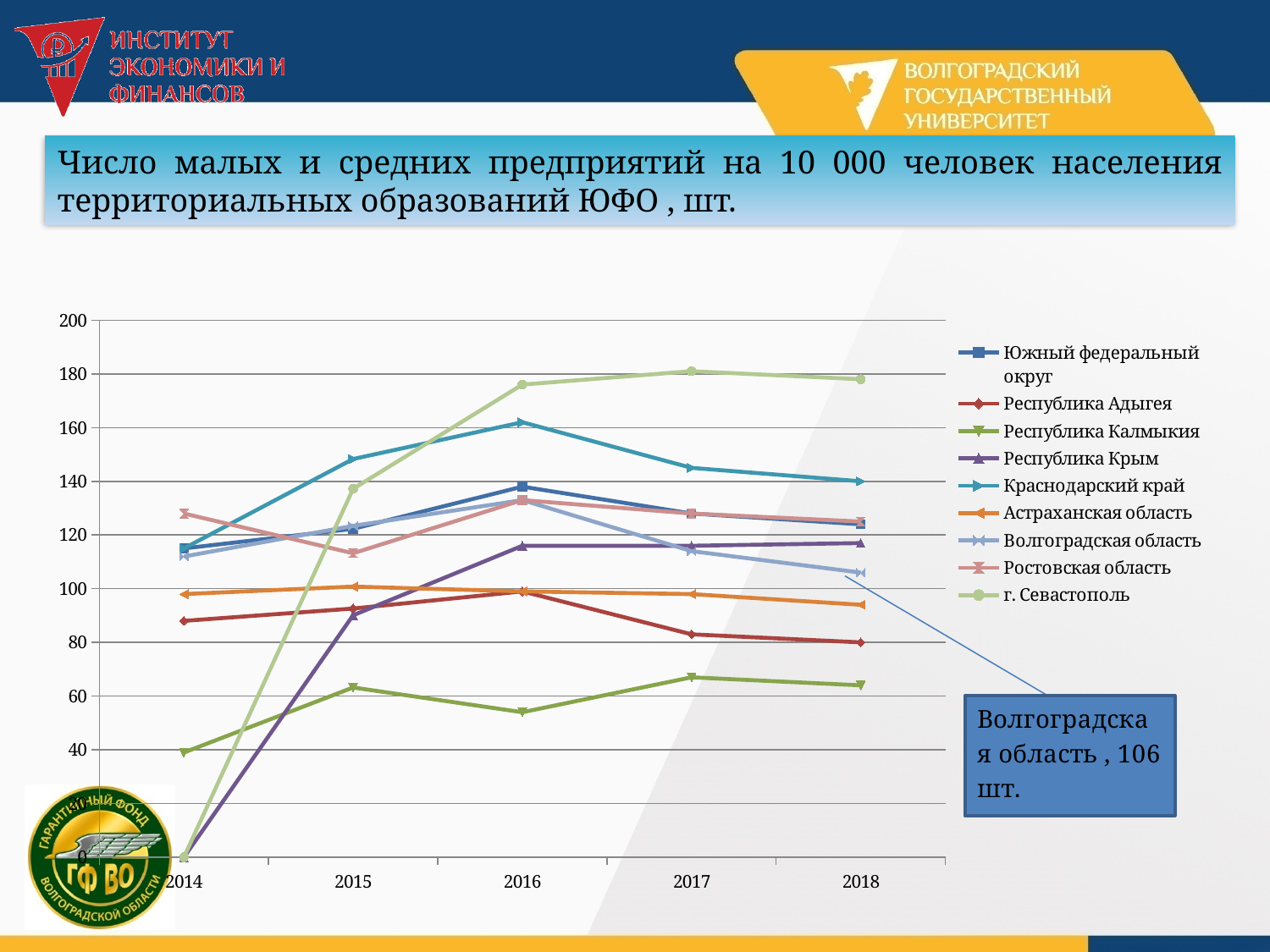
Is the value for Республика Калмыкия in 2016 greater or less than 60? less How many years are shown on the x axis? 5 In 2017, which is higher: Краснодарский край or Астраханская область? Краснодарский край Which series has the lowest value in 2018? Республика Калмыкия Which series has the highest value in 2018? г. Севастополь Is the value for г. Севастополь in 2016 greater or less than 160? greater What kind of chart is shown on the slide? line chart Which series has the highest value in 2014? Ростовская область How many series does the legend list? 9 Does the value for Республика Крым rise or fall from 2014 to 2016? rise What is the value for Волгоградская область in 2018? 106 шт. Is the value for Астраханская область in 2018 greater or less than 100? less